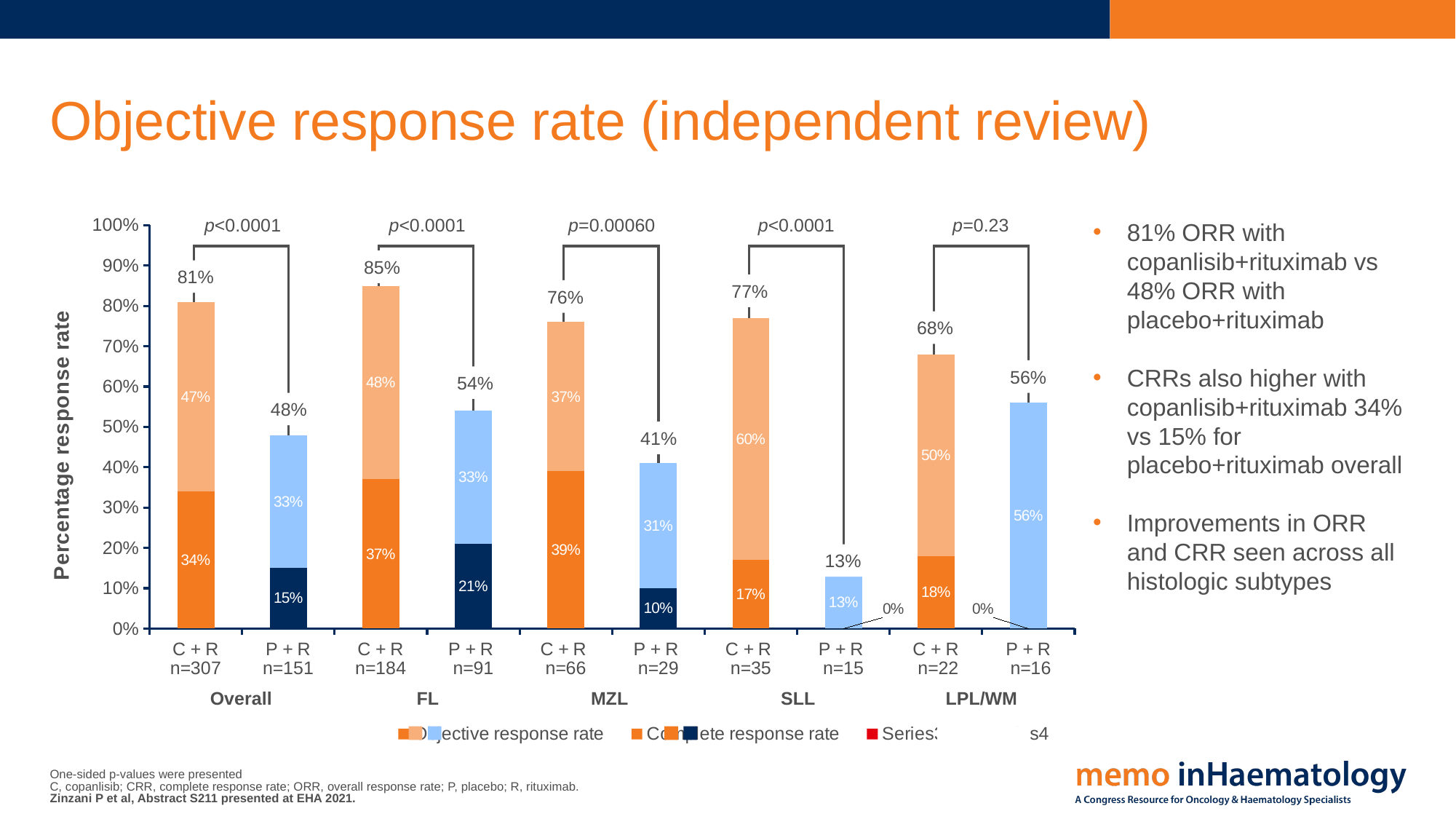
What kind of chart is shown on the slide? Stacked bar chart What value is printed in the dark blue (lower) segment of the P + R bar in the FL group? 21% What is the objective response rate shown above the P + R bar in the SLL group? 13% What p-value is shown above the LPL/WM group? p=0.23 Which bar has the lowest objective response rate on the chart? P + R in SLL (13%) In the LPL/WM group, which arm has the higher objective response rate, C + R or P + R? C + R What value is printed in the dark orange (lower) segment of the C + R bar in the Overall group? 34% Which bar has the highest objective response rate on the chart? C + R in FL (85%) What is the objective response rate shown above the C + R bar in the FL group? 85% Is the objective response rate for C + R in the MZL group greater or less than 70%? greater How many histologic subtype groups are shown along the x axis? 4 What is the difference between the objective response rates of C + R (81%) and P + R (48%) in the Overall group? 33 percentage points